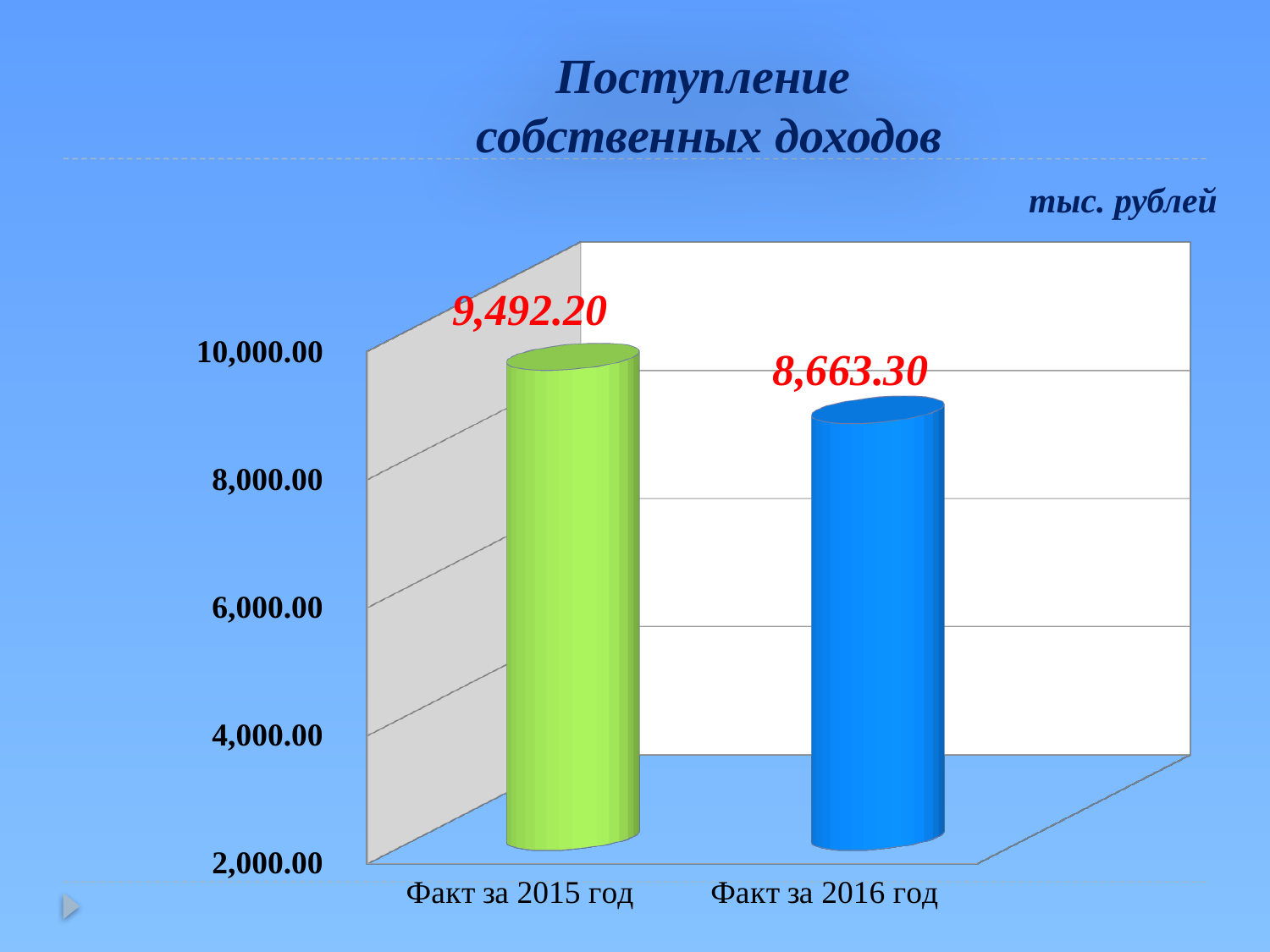
Is the value for Факт за 2016 год greater or less than 8,000.00? greater What is the value for Факт за 2016 год? 8,663.30 What is the difference between the values for Факт за 2015 год and Факт за 2016 год? 828.90 Which category has the lowest value? Факт за 2016 год Which category has the highest value? Факт за 2015 год Which is larger, the value for Факт за 2015 год or the value for Факт за 2016 год? Факт за 2015 год What is the value for Факт за 2015 год? 9,492.20 Do the values rise or fall from Факт за 2015 год to Факт за 2016 год? fall What unit of measurement is indicated for the chart? тыс. рублей Is the value for Факт за 2015 год greater or less than 10,000.00? less What kind of chart is shown on the slide? bar chart How many categories are shown on the chart? 2